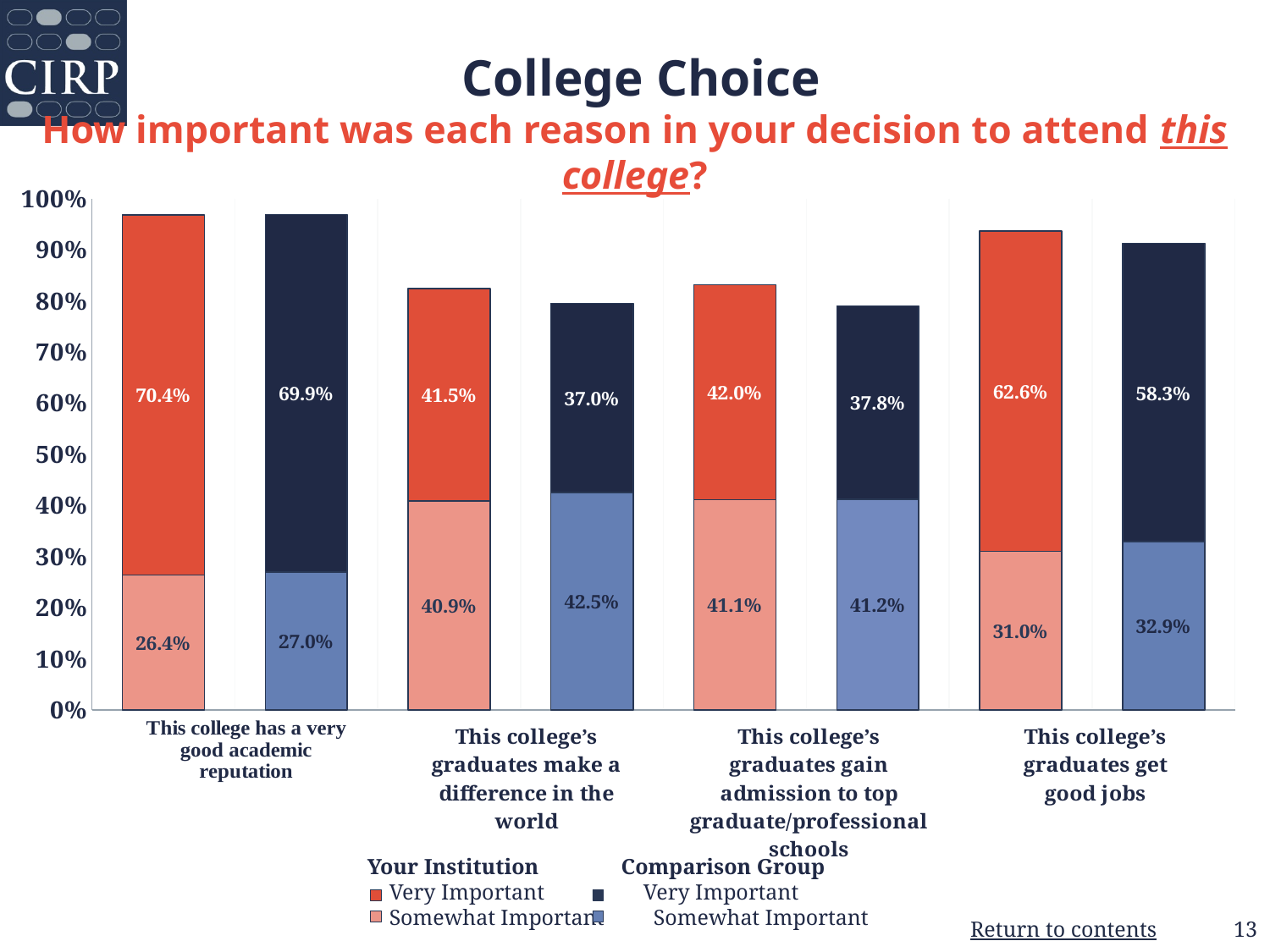
For "This college's graduates make a difference in the world", which is larger: the Very Important percentage for Your Institution or for the Comparison Group? Your Institution What percentage of Your Institution students rated "This college has a very good academic reputation" as Very Important? 70.4% How many entries does the chart legend list? 4 How many reasons (categories) are shown on the x axis of the chart? 4 Among the Very Important ratings for Your Institution, which reason has the highest percentage? This college has a very good academic reputation What percentage of Your Institution students rated "This college's graduates gain admission to top graduate/professional schools" as Very Important? 42.0% Among the Very Important ratings for the Comparison Group, which reason has the lowest percentage? This college's graduates make a difference in the world What is the total height of the Your Institution stacked bar for "This college's graduates get good jobs"? 93.6% What is the difference between the Your Institution and Comparison Group Very Important percentages for "This college's graduates get good jobs"? 4.3% What kind of chart is shown on the slide? Stacked bar chart What is the total height of the Comparison Group stacked bar for "This college has a very good academic reputation"? 96.9% What percentage of the Comparison Group rated "This college's graduates get good jobs" as Somewhat Important? 32.9%